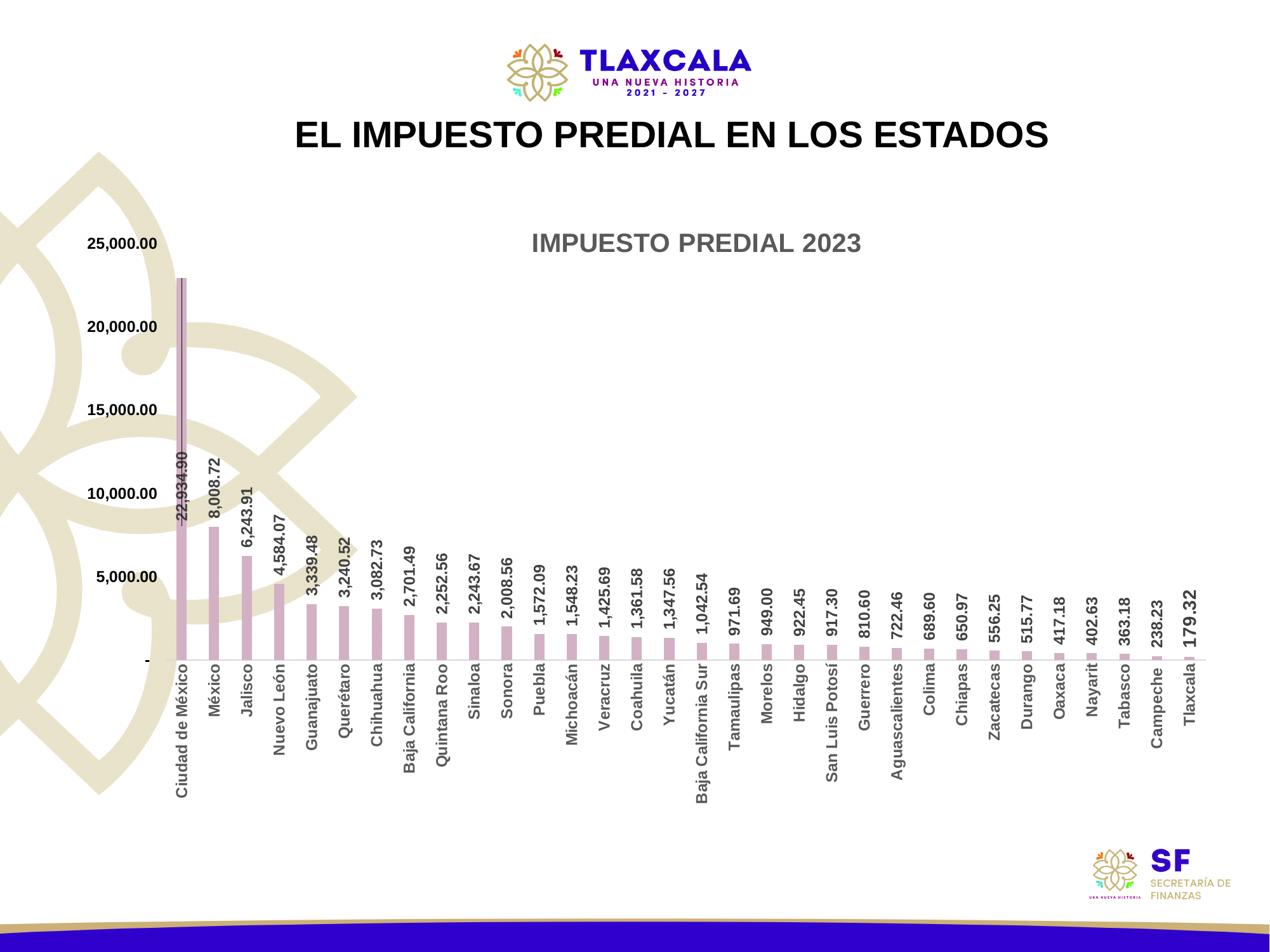
What is the value for Tlaxcala in the IMPUESTO PREDIAL 2023 chart? 179.32 What is the value for Yucatán in the IMPUESTO PREDIAL 2023 chart? 1,347.56 How many states are shown in the IMPUESTO PREDIAL 2023 chart? 32 Do the values in the IMPUESTO PREDIAL 2023 chart rise or fall from left to right? fall Is the value for Ciudad de México in the IMPUESTO PREDIAL 2023 chart greater or less than 20,000.00? greater Which state has the lowest value in the IMPUESTO PREDIAL 2023 chart? Tlaxcala What is the value for Jalisco in the IMPUESTO PREDIAL 2023 chart? 6,243.91 What kind of chart is the IMPUESTO PREDIAL 2023 chart? bar chart What is the difference between the values for México and Jalisco in the IMPUESTO PREDIAL 2023 chart? 1,764.81 What is the difference between the values for Campeche and Tlaxcala in the IMPUESTO PREDIAL 2023 chart? 58.91 Which has a larger value in the IMPUESTO PREDIAL 2023 chart, Nuevo León or Guanajuato? Nuevo León Which state has the highest value in the IMPUESTO PREDIAL 2023 chart? Ciudad de México